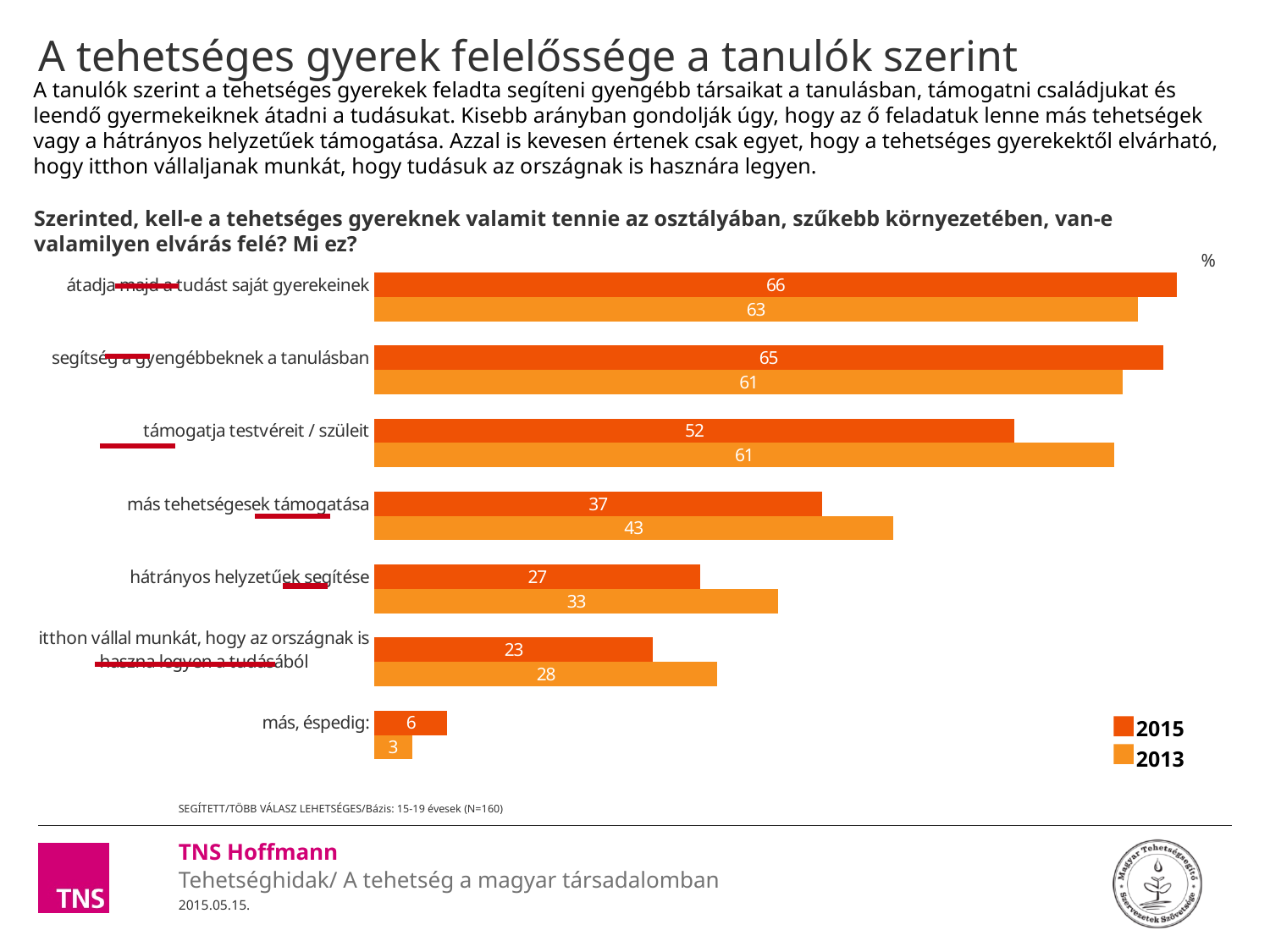
How many categories are plotted in the chart? 7 What is the 2013 value for "támogatja testvéreit / szüleit"? 61 What is the 2013 value for "más tehetségesek támogatása"? 43 How many series does the legend list? 2 What is the 2015 value for "átadja majd a tudást saját gyerekeinek"? 66 What kind of chart is shown on the slide? bar chart What is the difference between the 2015 and 2013 values for "hátrányos helyzetűek segítése"? 6 What is the 2015 value for "itthon vállal munkát, hogy az országnak is haszna legyen a tudásából"? 23 Which is larger for "támogatja testvéreit / szüleit": the 2015 value or the 2013 value? 2013 Which year does the darker orange colour represent in the legend? 2015 Which category has the lowest 2013 value? más, éspedig: Which category has the highest 2015 value? átadja majd a tudást saját gyerekeinek